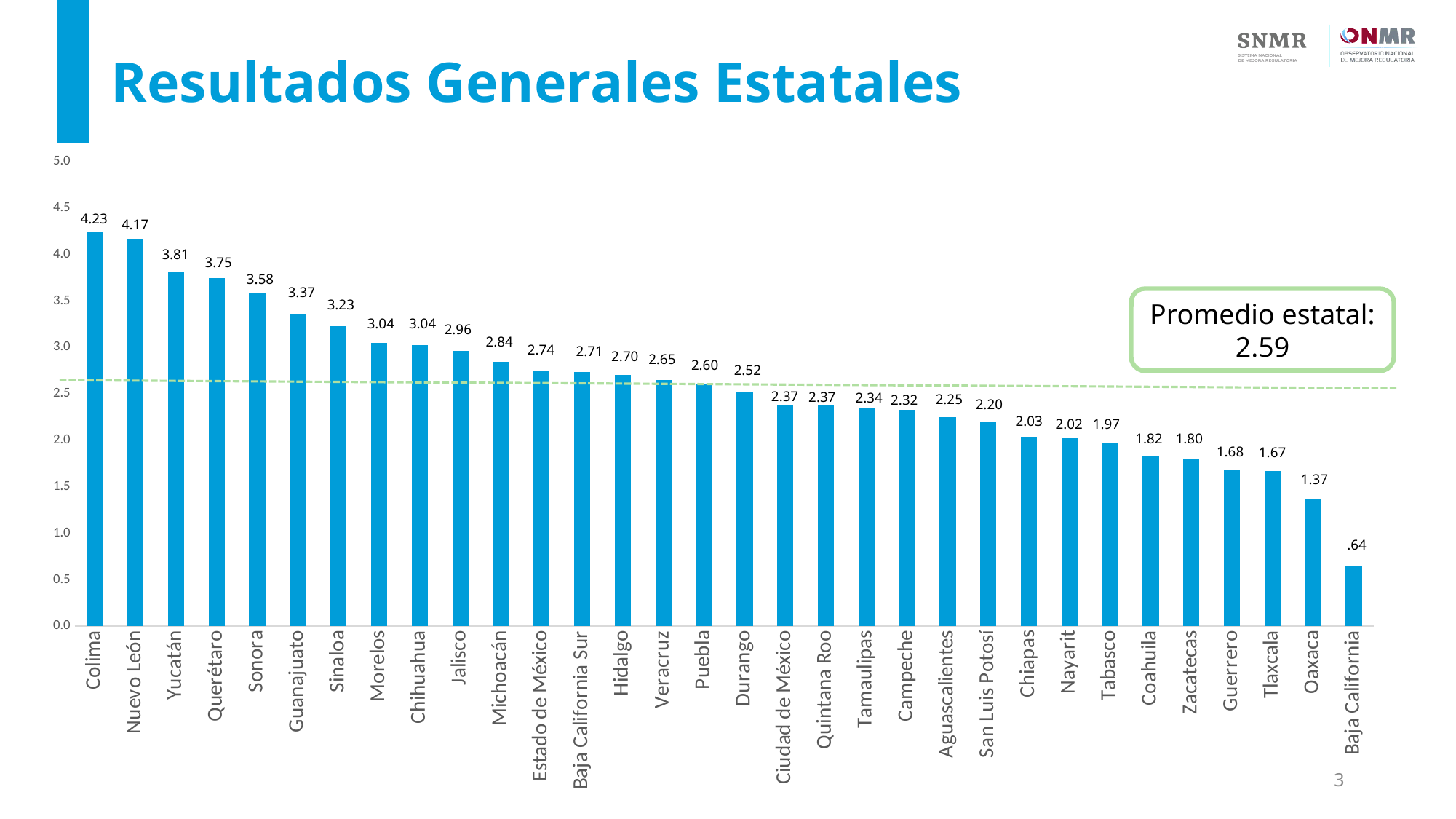
Which state has the highest value? Colima Which is larger, the value for Sonora or the value for Guanajuato? Sonora What is the value for Tamaulipas? 2.34 What is the value for Oaxaca? 1.37 What is the value for Colima? 4.23 What kind of chart is shown on the slide? Bar chart How many states are shown on the chart? 32 What is the 'Promedio estatal' value shown in the box on the chart? 2.59 What is the difference between the values for Yucatán and Querétaro? 0.06 Do the values rise or fall from left to right along the x axis? Fall Which state has the lowest value? Baja California What is the difference between the values for Colima and Nuevo León? 0.06